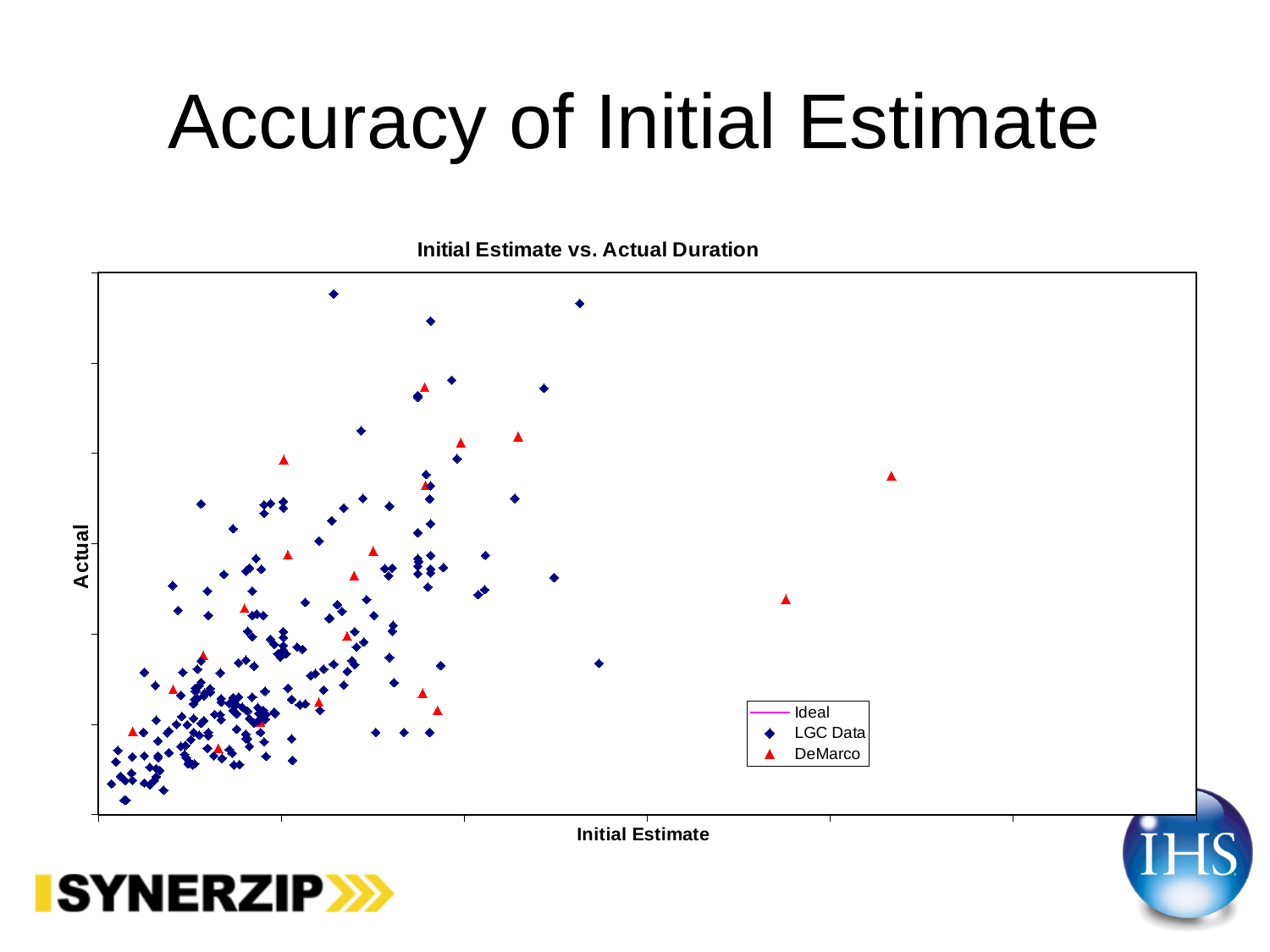
Which series is plotted with red triangle markers? DeMarco Which series has more plotted points on the chart, LGC Data or DeMarco? LGC Data What are the three entries listed in the chart's legend? Ideal, LGC Data, DeMarco What is the title of the chart? Initial Estimate vs. Actual Duration What kind of chart is shown on the slide? Scatter chart Do the plotted Actual values generally rise or fall as the Initial Estimate increases along the x axis? Rise How many series does the legend of the chart list? 3